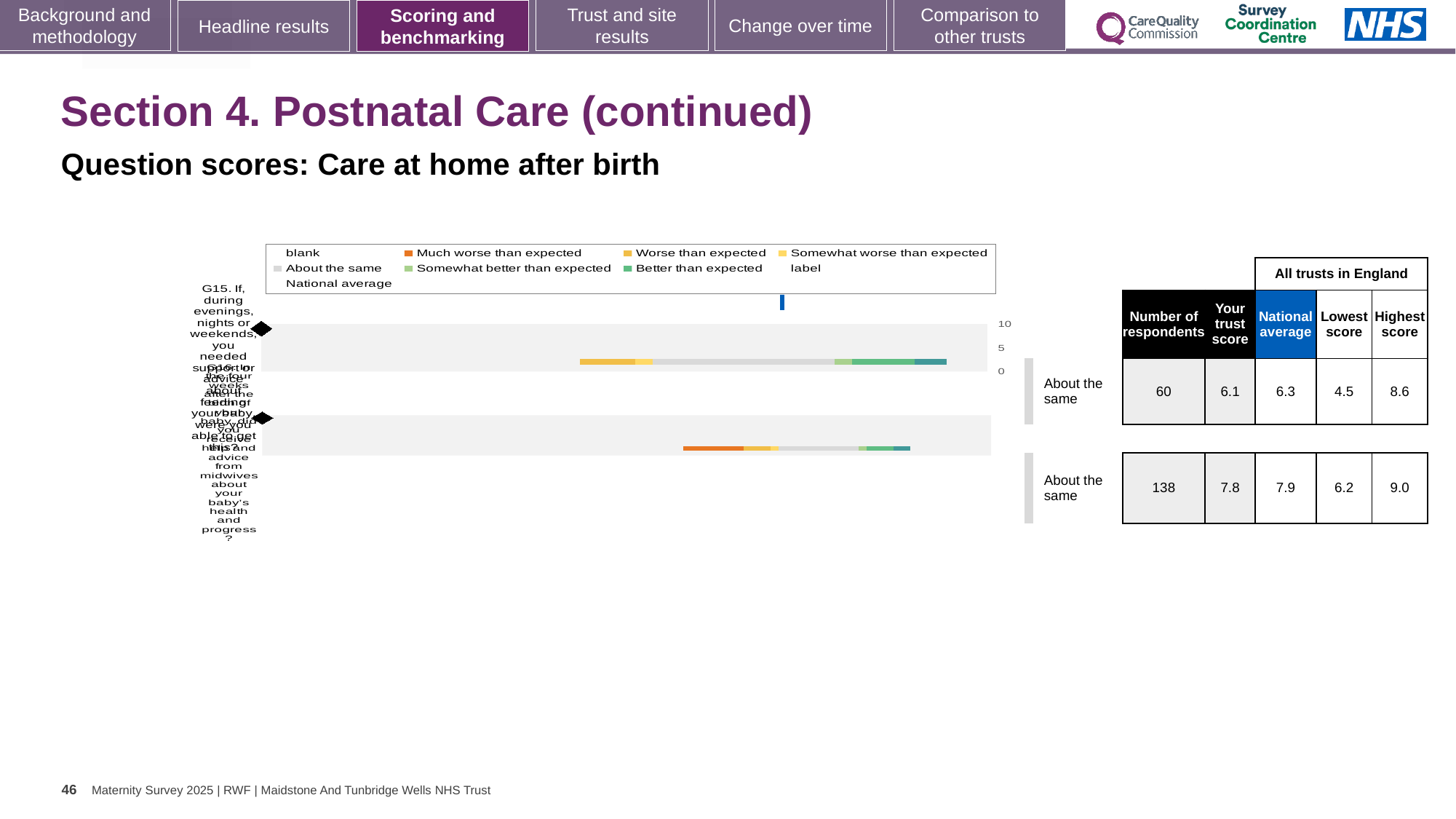
How many entries does the chart legend list? 9 In the table to the right of the chart, what is the highest score in the first row? 8.6 In the table to the right of the chart, what is the difference between the highest score and the lowest score in the second row? 2.8 In the table to the right of the chart, what is the number of respondents in the first row? 60 In the table to the right of the chart, which is larger in the first row: 'Your trust score' or the national average? National average What colour does the legend use for 'Much worse than expected'? orange How many bars are plotted in the chart? 2 In the table to the right of the chart, what is the difference between the national average and 'Your trust score' in the first row? 0.2 In the table to the right of the chart, what is 'Your trust score' in the second row? 7.8 In the table to the right of the chart, what is the national average in the second row? 7.9 What kind of chart is shown on the slide? bar chart What is the highest tick value shown on the chart's axis? 10